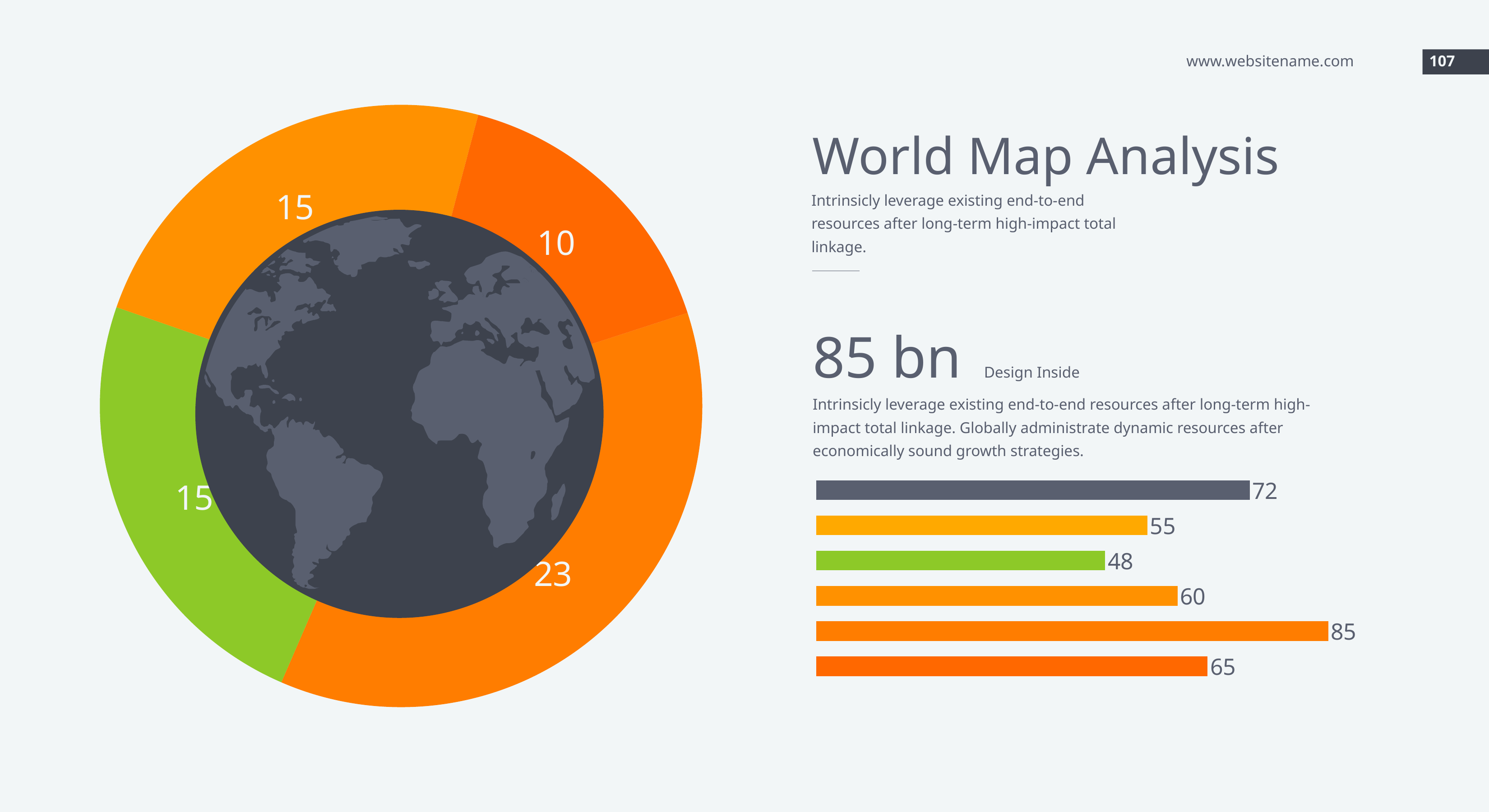
In the bar chart on the right, what is the value of the top (dark grey) bar? 72 In the donut chart on the left, how many slices are there? 4 In the bar chart on the right, what is the value of the green bar? 48 In the donut chart on the left, what is the total of all the slice values? 63 In the donut chart on the left, what is the value of the green slice? 15 In the bar chart on the right, what is the difference between the longest bar (85) and the shortest bar (48)? 37 In the donut chart on the left, what is the value of the smallest slice? 10 In the bar chart on the right, what is the value of the longest bar? 85 What kind of chart is on the left side of the slide? donut chart What kind of chart is on the right side of the slide, below the text? bar chart In the bar chart on the right, how many bars are there? 6 In the donut chart on the left, what is the value of the largest slice? 23